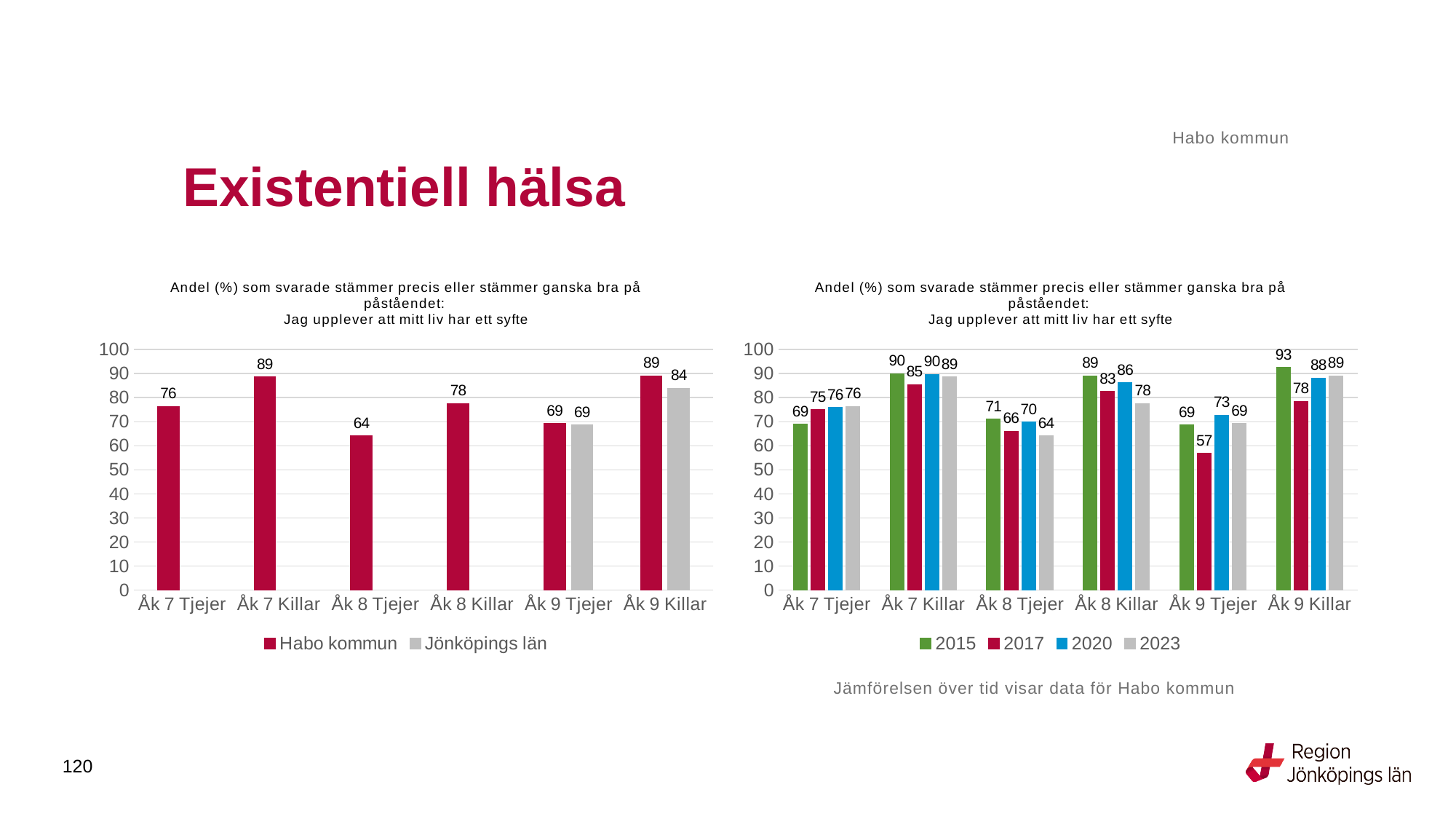
In the left chart, how many series does the legend list? 2 In the right chart, what is the difference between the 2015 and 2023 values for Åk 8 Killar? 11 What type of chart is the right chart? Bar chart In the right chart, how many series does the legend list? 4 In the right chart, what is the 2020 value for Åk 8 Killar? 86 In the left chart, what is the value for Habo kommun for Åk 8 Tjejer? 64 In the left chart, what is the value for Jönköpings län for Åk 9 Killar? 84 In the right chart, which category has the highest 2015 value? Åk 9 Killar In the left chart, which category has the lowest Habo kommun value? Åk 8 Tjejer In the right chart, what is the 2017 value for Åk 9 Tjejer? 57 In the left chart, what is the difference between the Habo kommun values for Åk 7 Killar and Åk 7 Tjejer? 13 In the right chart, which is larger for Åk 8 Tjejer: the 2015 value or the 2023 value? 2015